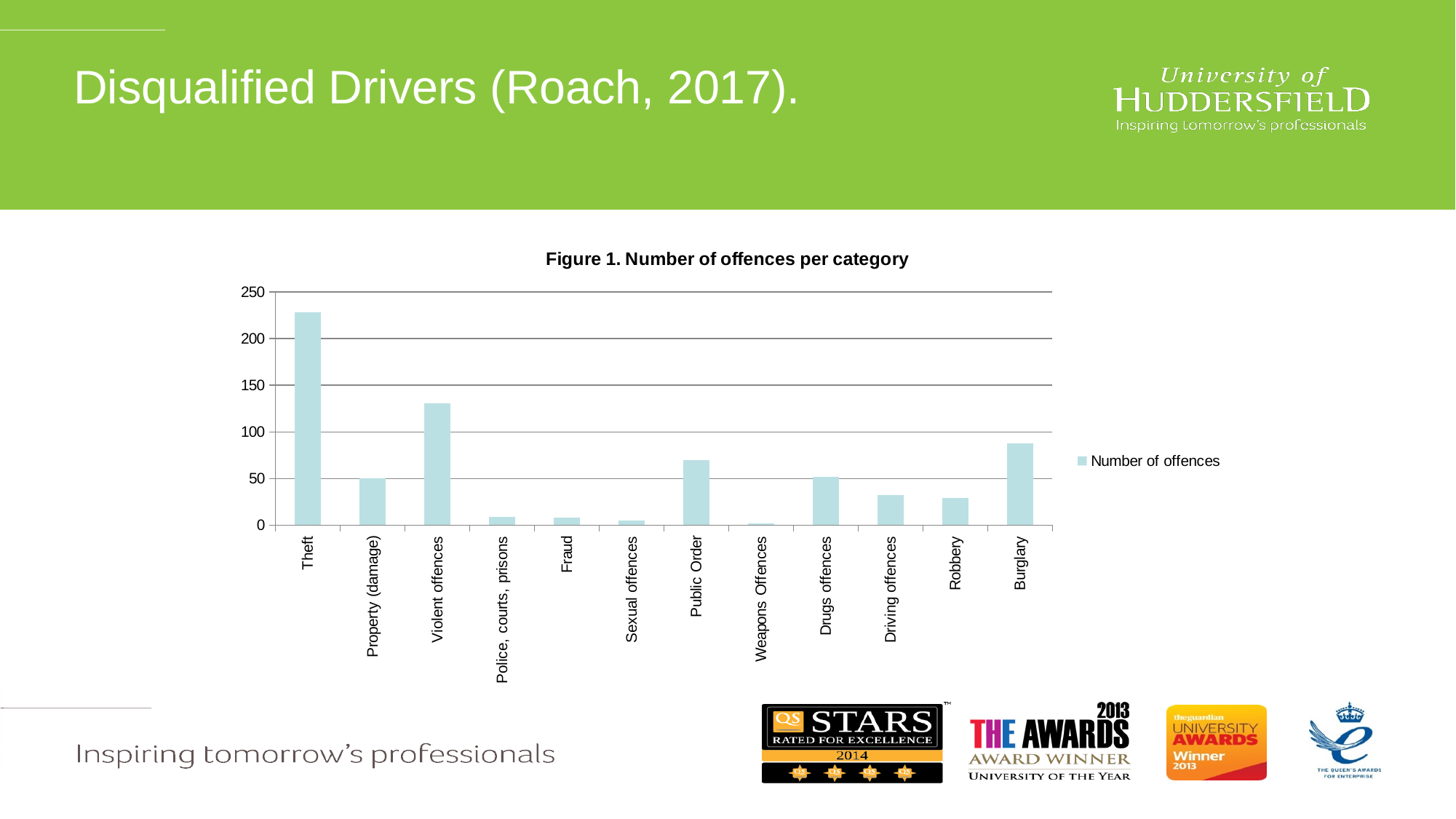
Is the value for Violent offences greater or less than 100? greater Which has more offences, Violent offences or Burglary? Violent offences Which has more offences, Public Order or Drugs offences? Public Order What type of chart is shown on the slide? Bar chart Which offence category has the lowest number of offences? Weapons Offences Which offence category has the highest number of offences? Theft How many series does the legend list? 1 How many offence categories are shown on the x axis? 12 Is the value for Burglary greater or less than 100? less Is the value for Theft greater or less than 200? greater What is the title of the chart? Figure 1. Number of offences per category